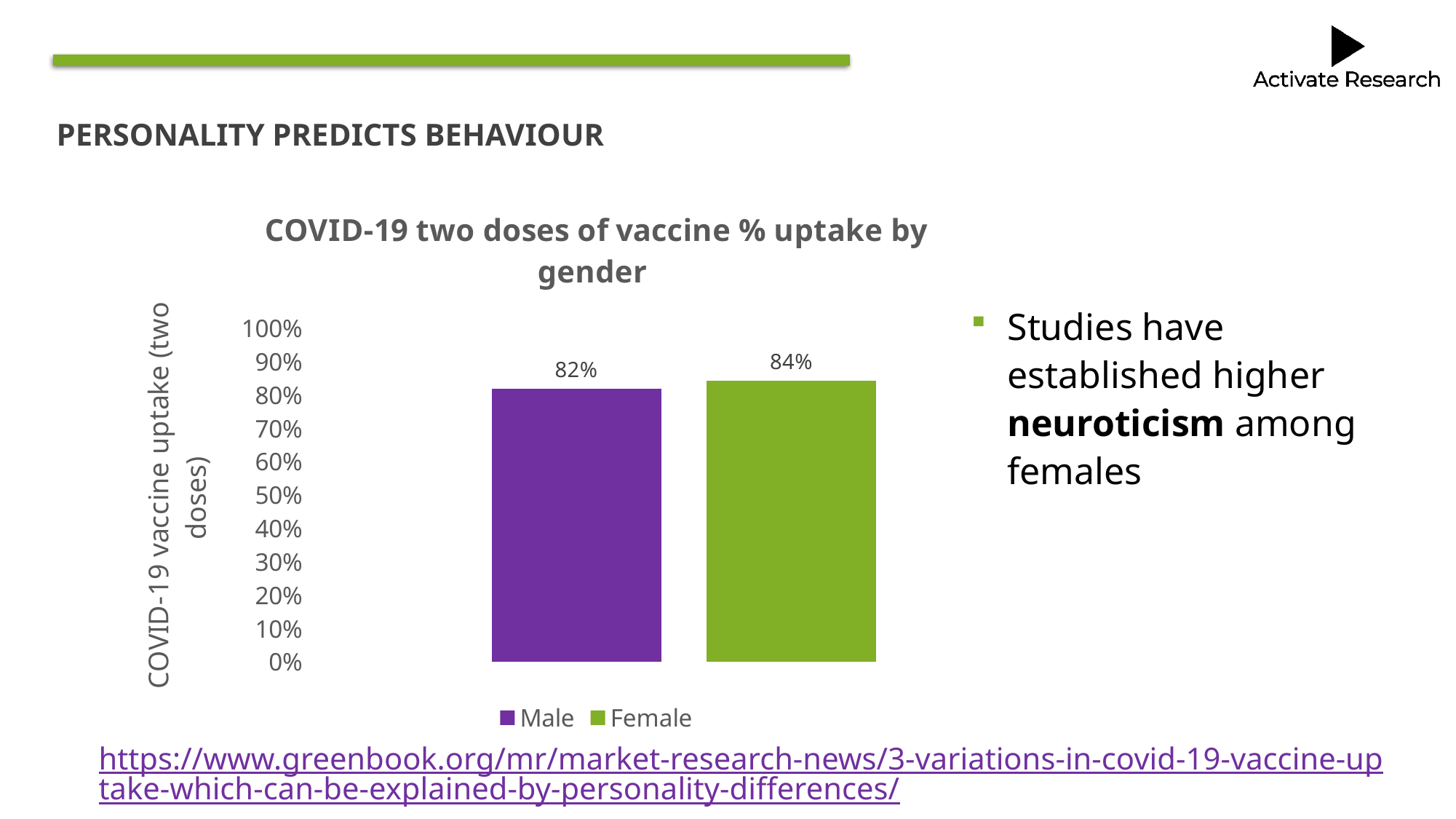
What is the two-dose vaccine uptake for Male? 82% What kind of chart is shown on the slide? Bar chart Is the two-dose vaccine uptake for Female greater or less than 80%? greater What is the difference in two-dose vaccine uptake between Female and Male? 2% How many bars are plotted in the chart? 2 How many series does the legend list? 2 Which gender has the higher two-dose vaccine uptake? Female What is the title of the chart? COVID-19 two doses of vaccine % uptake by gender Which gender has the lower two-dose vaccine uptake? Male What colour is the Female bar in the chart? Green What is the two-dose vaccine uptake for Female? 84% Is the two-dose vaccine uptake for Male greater or less than 90%? less